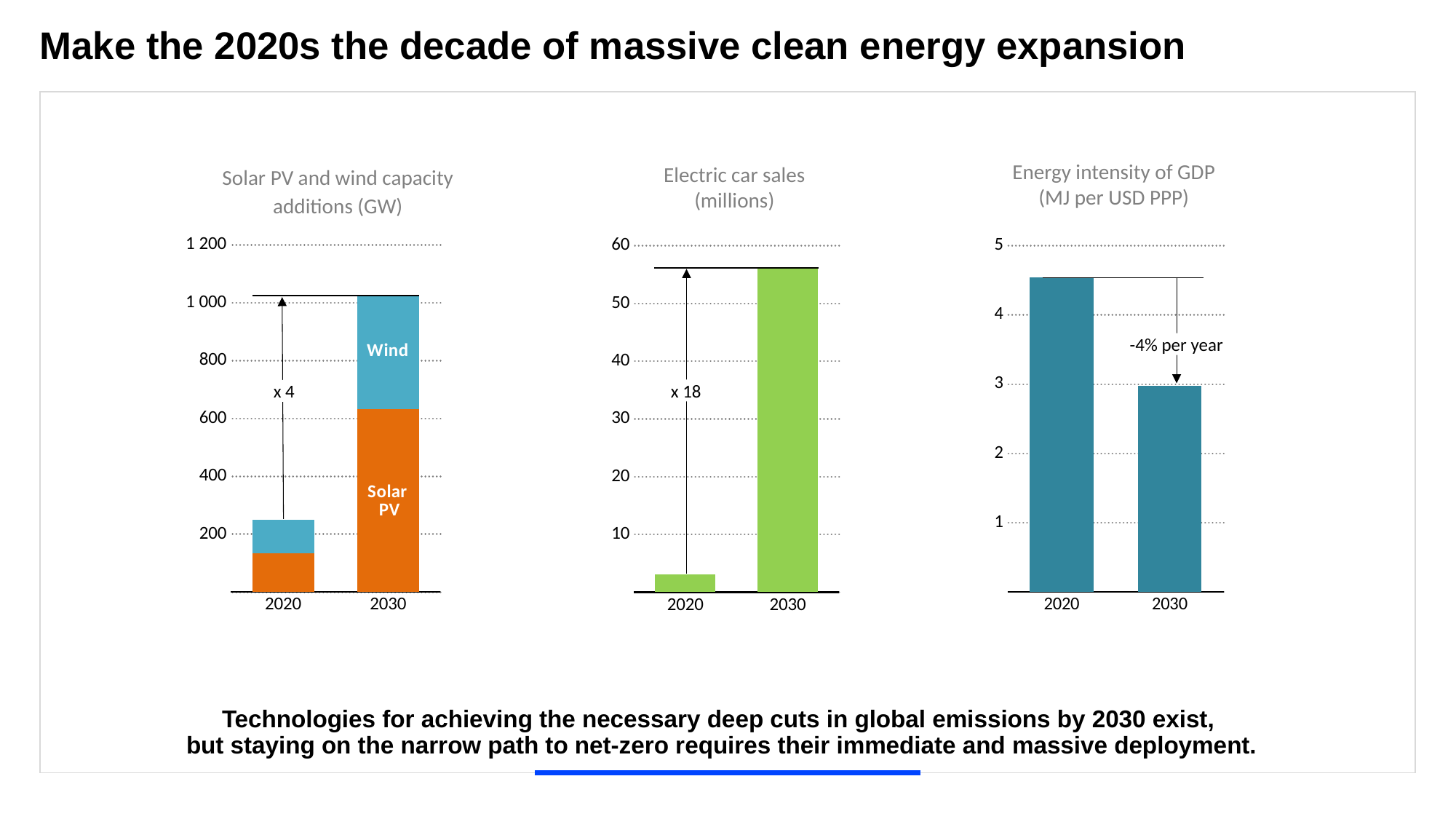
On the 'Solar PV and wind capacity additions (GW)' chart, is the total value for 2030 greater or less than 800? greater On the 'Solar PV and wind capacity additions (GW)' chart, is the total value for 2020 greater or less than 400? less On the 'Solar PV and wind capacity additions (GW)' chart, which two series make up the stacked bars? Solar PV and Wind What kind of chart is the 'Electric car sales (millions)' chart? bar chart On the 'Electric car sales (millions)' chart, is the value for 2030 greater or less than 50? greater On the 'Solar PV and wind capacity additions (GW)' chart, which year has the higher total capacity additions, 2020 or 2030? 2030 On the 'Energy intensity of GDP (MJ per USD PPP)' chart, do the values rise or fall from 2020 to 2030? fall On the 'Electric car sales (millions)' chart, what multiplier is annotated between 2020 and 2030? x 18 On the 'Solar PV and wind capacity additions (GW)' chart, what multiplier is annotated between 2020 and 2030? x 4 On the 'Energy intensity of GDP (MJ per USD PPP)' chart, which year has the lower value, 2020 or 2030? 2030